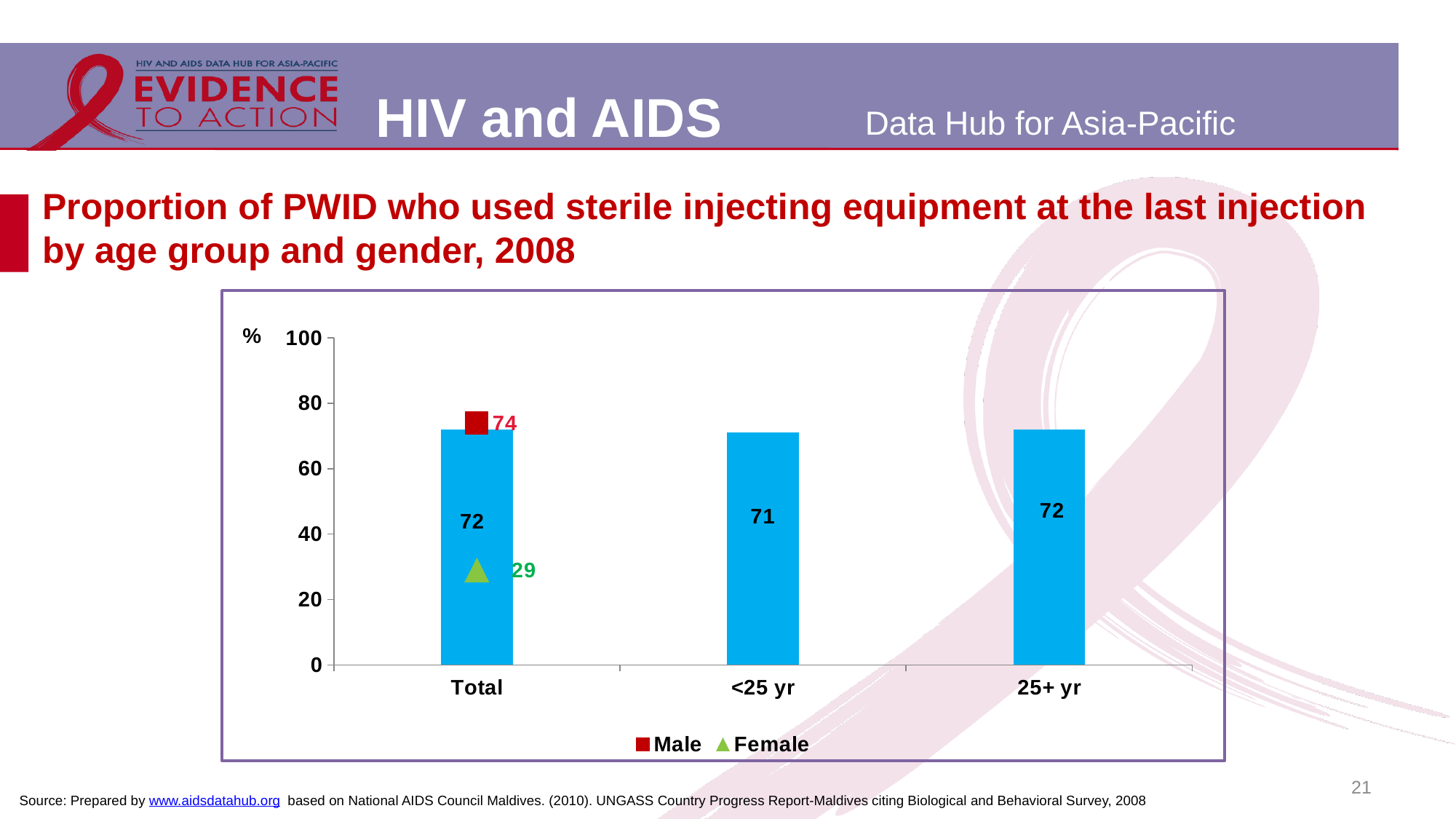
What is the value of the bar for the 25+ yr age group? 72 What is the Female value shown for the Total category? 29 What is the difference between the Male and Female values for the Total category? 45 How many age-group categories are shown on the x axis? 3 Is the Female value for Total greater or less than 40? less How many series does the legend list? 2 What kind of chart is shown on the slide? bar chart Which age group has the lowest bar value? <25 yr What is the value of the bar for the <25 yr age group? 71 Which is larger for the Total category, the Male value or the Female value? Male What is the Male value shown for the Total category? 74 What is the value of the Total bar? 72